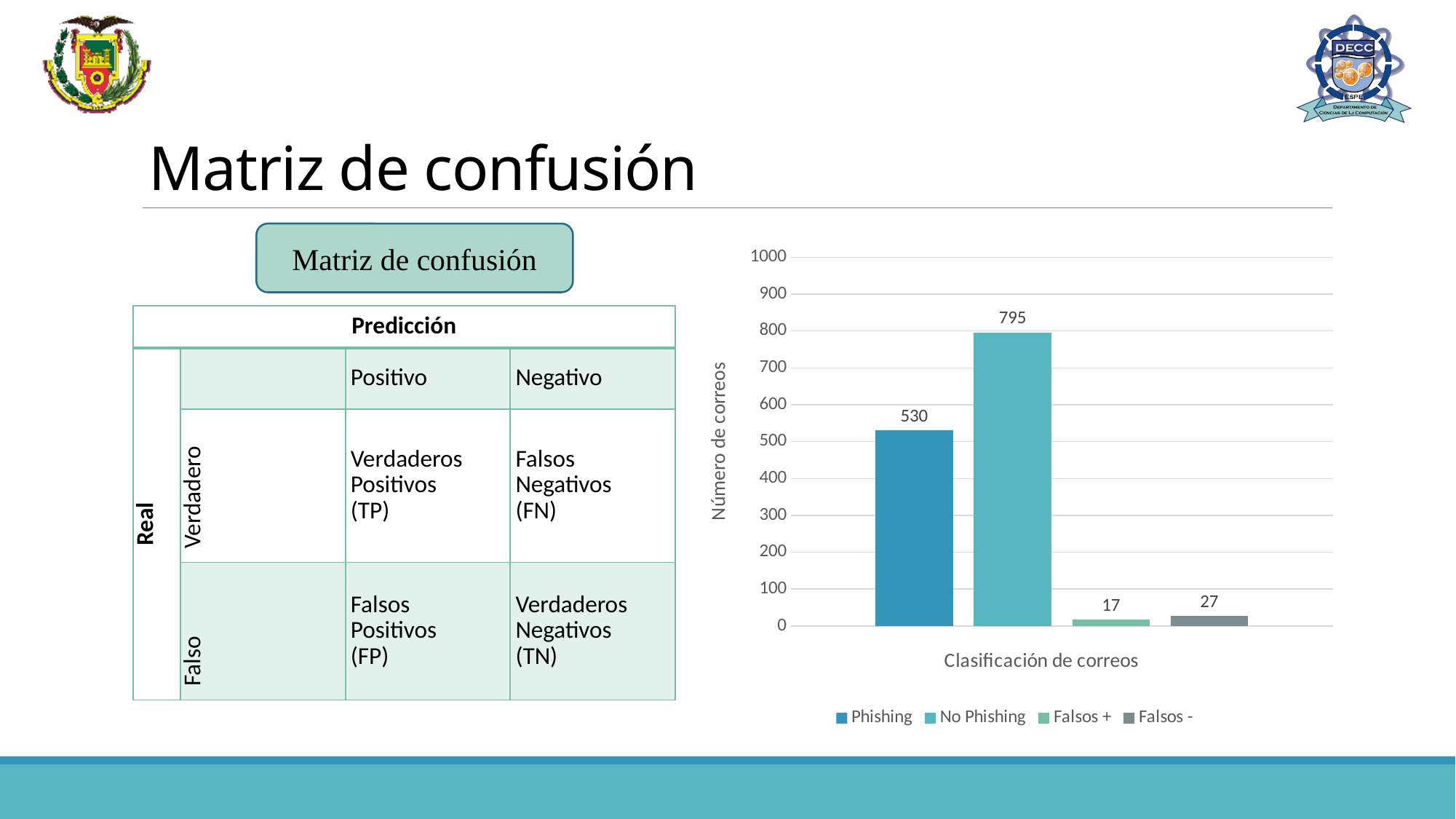
What is the value for Falsos + in the chart? 17 What is the value for Falsos - in the chart? 27 What is the value for No Phishing in the chart? 795 How many series does the legend list? 4 What kind of chart is shown on the slide? Bar chart What is the value for Phishing in the chart? 530 What is the difference between the Falsos - and Falsos + values? 10 What is the label of the vertical axis of the chart? Número de correos Which series has the highest value in the chart? No Phishing Which series has the lowest value in the chart? Falsos + Which is larger, the value for Phishing or the value for No Phishing? No Phishing What is the difference between the No Phishing and Phishing values? 265